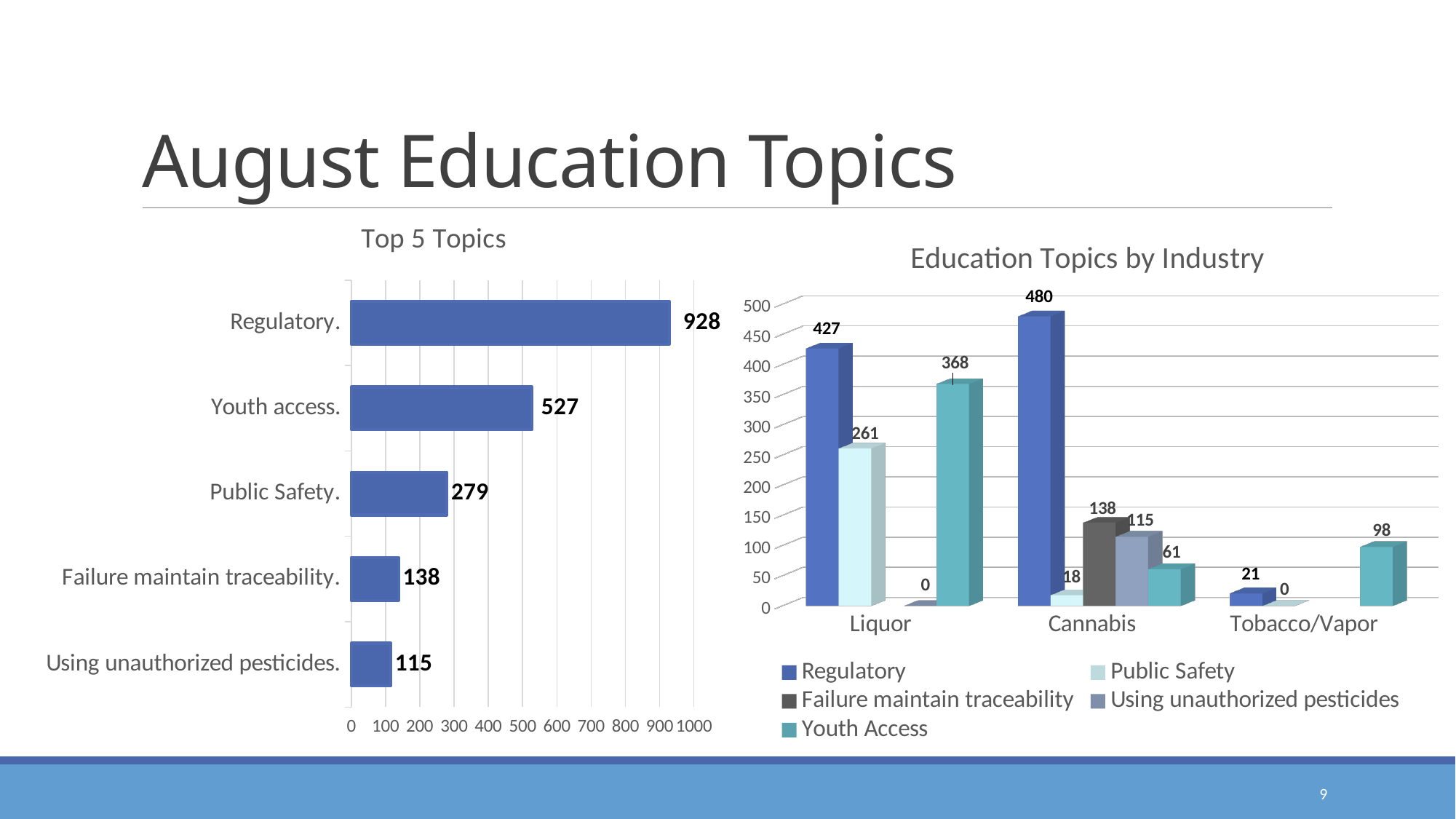
In the Education Topics by Industry chart, how many series does the legend list? 5 In the Education Topics by Industry chart, what is the Youth Access value for Liquor? 368 In the Top 5 Topics chart, what is the value for Regulatory? 928 In the Education Topics by Industry chart, what is the difference between the Regulatory values for Cannabis and Liquor? 53 In the Education Topics by Industry chart, what is the Regulatory value for Cannabis? 480 In the Top 5 Topics chart, what is the difference between Regulatory and Youth access? 401 In the Education Topics by Industry chart, what is the Youth Access value for Tobacco/Vapor? 98 In the Top 5 Topics chart, what is the value for Youth access? 527 In the Top 5 Topics chart, how many topics are shown? 5 In the Top 5 Topics chart, which topic has the lowest value? Using unauthorized pesticides. What kind of chart is the Top 5 Topics chart? Bar chart In the Education Topics by Industry chart, which is larger for Cannabis: Failure maintain traceability or Using unauthorized pesticides? Failure maintain traceability